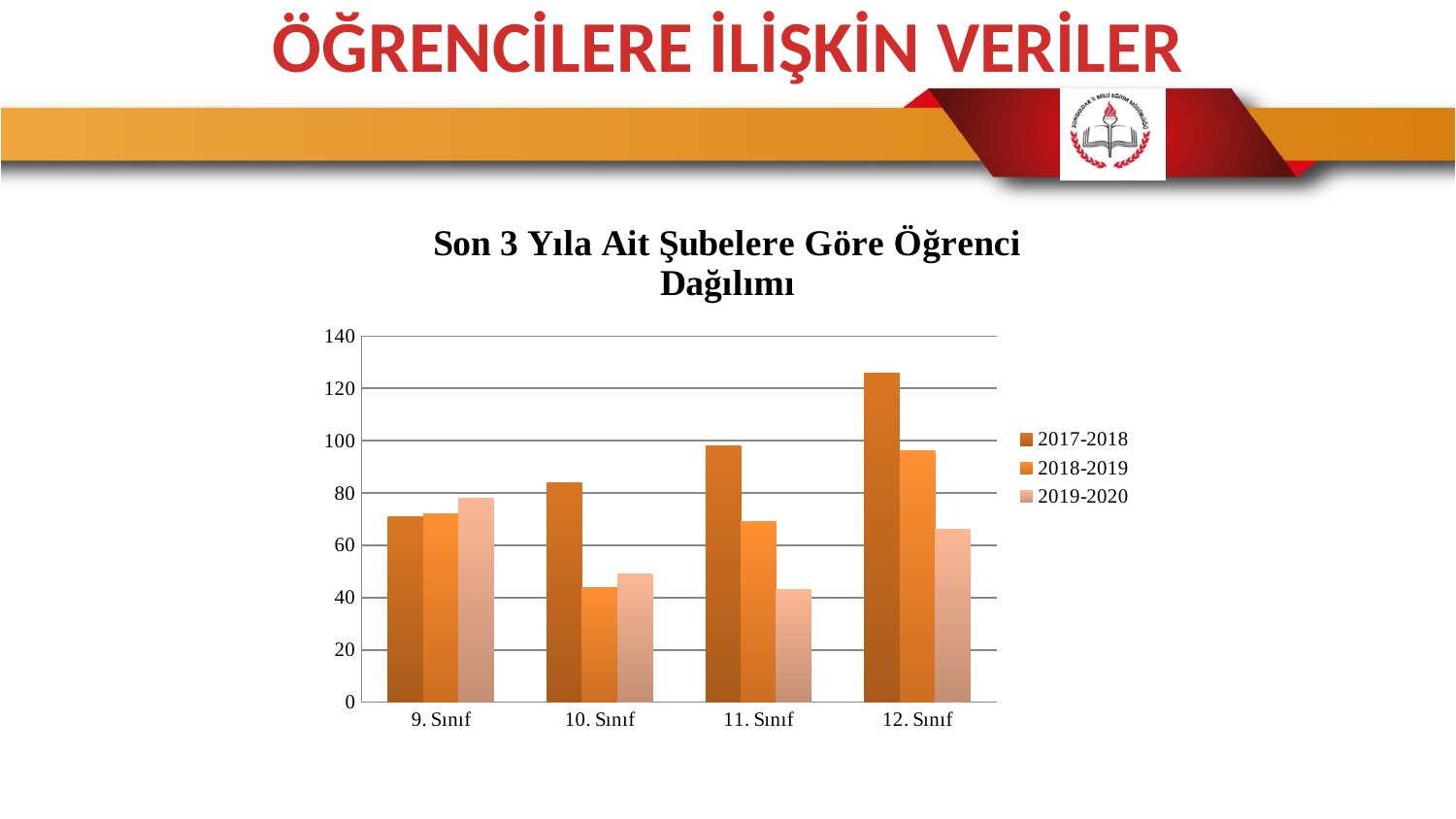
What kind of chart is shown on the slide? bar chart Is the 2018-2019 value for 12. Sınıf greater or less than 100? less For 11. Sınıf, which is larger: the 2017-2018 value or the 2018-2019 value? 2017-2018 Which class has the highest value for the 2017-2018 series? 12. Sınıf How many series does the legend list? 3 Is the 2017-2018 value for 10. Sınıf greater or less than 80? greater How many class categories are shown on the x axis? 4 What is the title of the chart? Son 3 Yıla Ait Şubelere Göre Öğrenci Dağılımı Is the 2017-2018 value for 12. Sınıf greater or less than 120? greater Do the 2017-2018 values rise or fall from 9. Sınıf to 12. Sınıf? rise Which class has the lowest value for the 2019-2020 series? 11. Sınıf